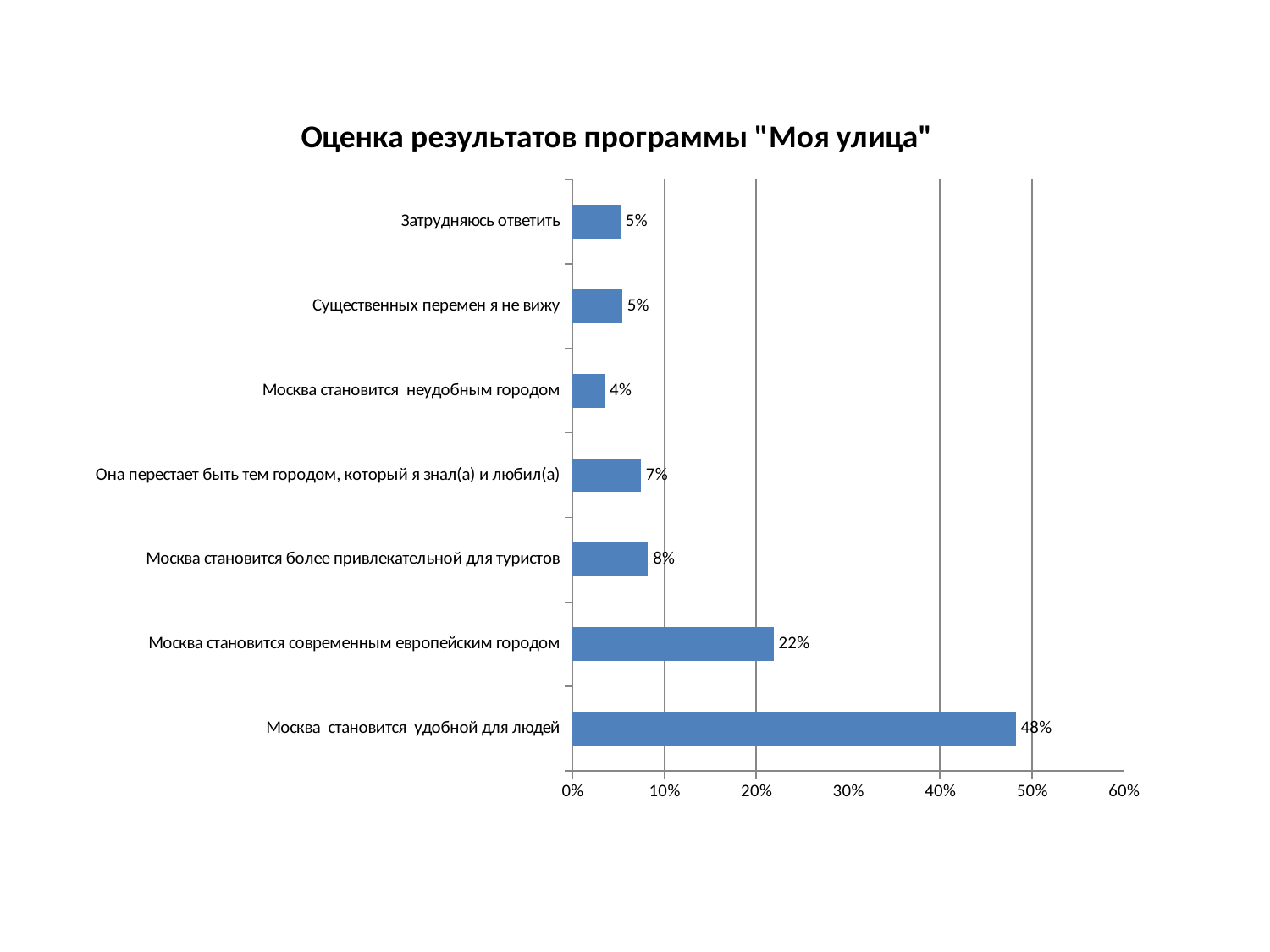
Which category has the lowest value? Москва становится неудобным городом Which is larger: the value for "Она перестает быть тем городом, который я знал(а) и любил(а)" or for "Москва становится более привлекательной для туристов"? Москва становится более привлекательной для туристов Is the value for "Москва становится современным европейским городом" greater or less than 30%? less Which category has the highest value? Москва становится удобной для людей What kind of chart is shown on the slide? bar chart What is the value for "Москва становится современным европейским городом"? 22% What is the title of the chart? Оценка результатов программы "Моя улица" What is the difference between the values for "Москва становится удобной для людей" and "Москва становится современным европейским городом"? 26% What is the value for "Москва становится удобной для людей"? 48% How many categories are shown in the chart? 7 What is the value for "Москва становится более привлекательной для туристов"? 8% What is the value for "Москва становится неудобным городом"? 4%